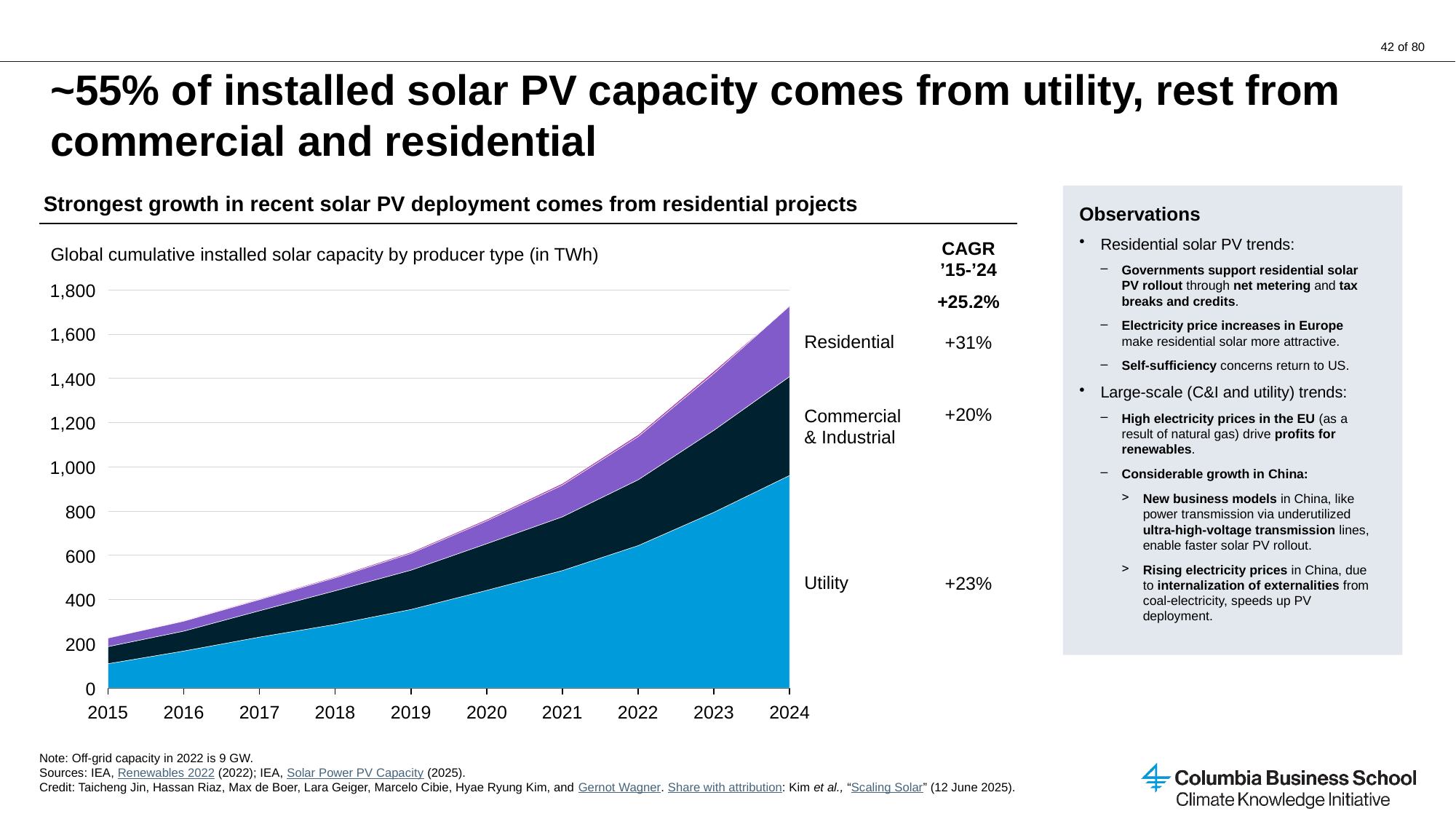
What is the CAGR '15-'24 shown for Commercial & Industrial? +20% What is the title of the chart? Global cumulative installed solar capacity by producer type (in TWh) What is the overall CAGR '15-'24 shown at the top of the CAGR column? +25.2% Does the total cumulative installed solar capacity rise or fall from 2015 to 2024? Rises What kind of chart is shown on the slide? Stacked area chart How many years are plotted along the x axis of the chart? 10 Which producer type has the lowest CAGR '15-'24? Commercial & Industrial Which producer type has the highest CAGR '15-'24? Residential Is the total cumulative installed solar capacity in 2024 greater or less than 1,600 TWh? greater What is the CAGR '15-'24 shown for Residential? +31% What is the CAGR '15-'24 shown for Utility? +23%